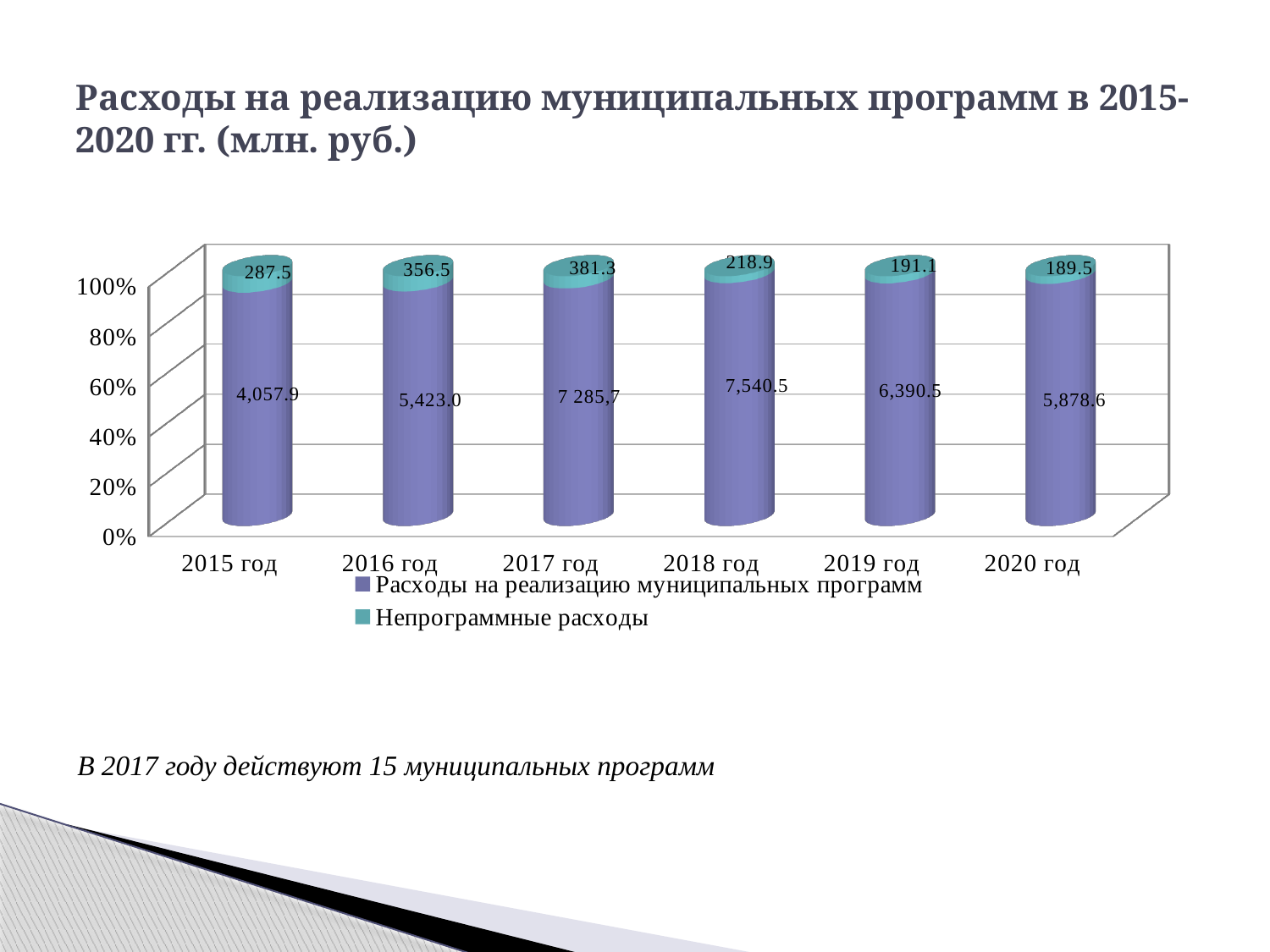
What is the value of 'Расходы на реализацию муниципальных программ' for 2020 год? 5,878.6 What is the value of 'Непрограммные расходы' for 2015 год? 287.5 How many series does the legend list? 2 What kind of chart is shown on the slide? Stacked bar chart Which is larger: 'Расходы на реализацию муниципальных программ' in 2019 год or in 2020 год? 2019 год Do the values for 'Расходы на реализацию муниципальных программ' rise or fall from 2015 год to 2018 год? Rise What is the difference between 'Расходы на реализацию муниципальных программ' in 2018 год and 2017 год? 254.8 Which year has the highest value for 'Расходы на реализацию муниципальных программ'? 2018 год How many years are shown on the x axis? 6 What is the value of 'Расходы на реализацию муниципальных программ' for 2018 год? 7,540.5 Which year has the lowest value for 'Непрограммные расходы'? 2020 год Which year has the highest value for 'Непрограммные расходы'? 2017 год